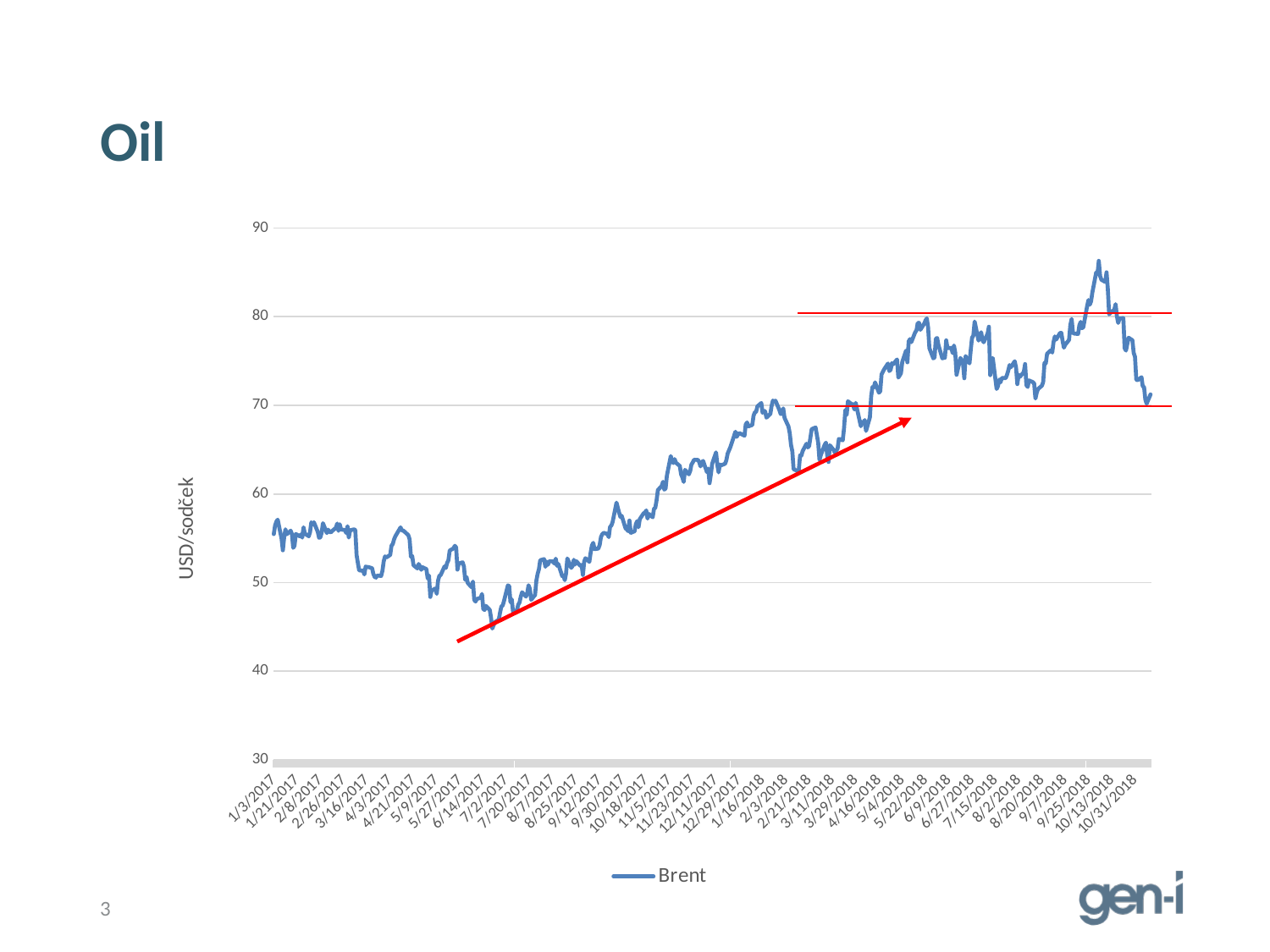
Does the Brent price rise or fall between 6/14/2017 and 1/16/2018? rise What is the name of the series shown in the legend? Brent Is the highest Brent value on the chart greater or less than 80? greater What kind of chart is shown on the slide? line chart How many series does the legend list? 1 Is the Brent value at 10/31/2018 greater or less than 80? less Is the Brent value at 1/3/2017 greater or less than 60? less What is the label on the vertical axis? USD/sodček Does the Brent price rise or fall between 1/3/2017 and 6/14/2017? fall